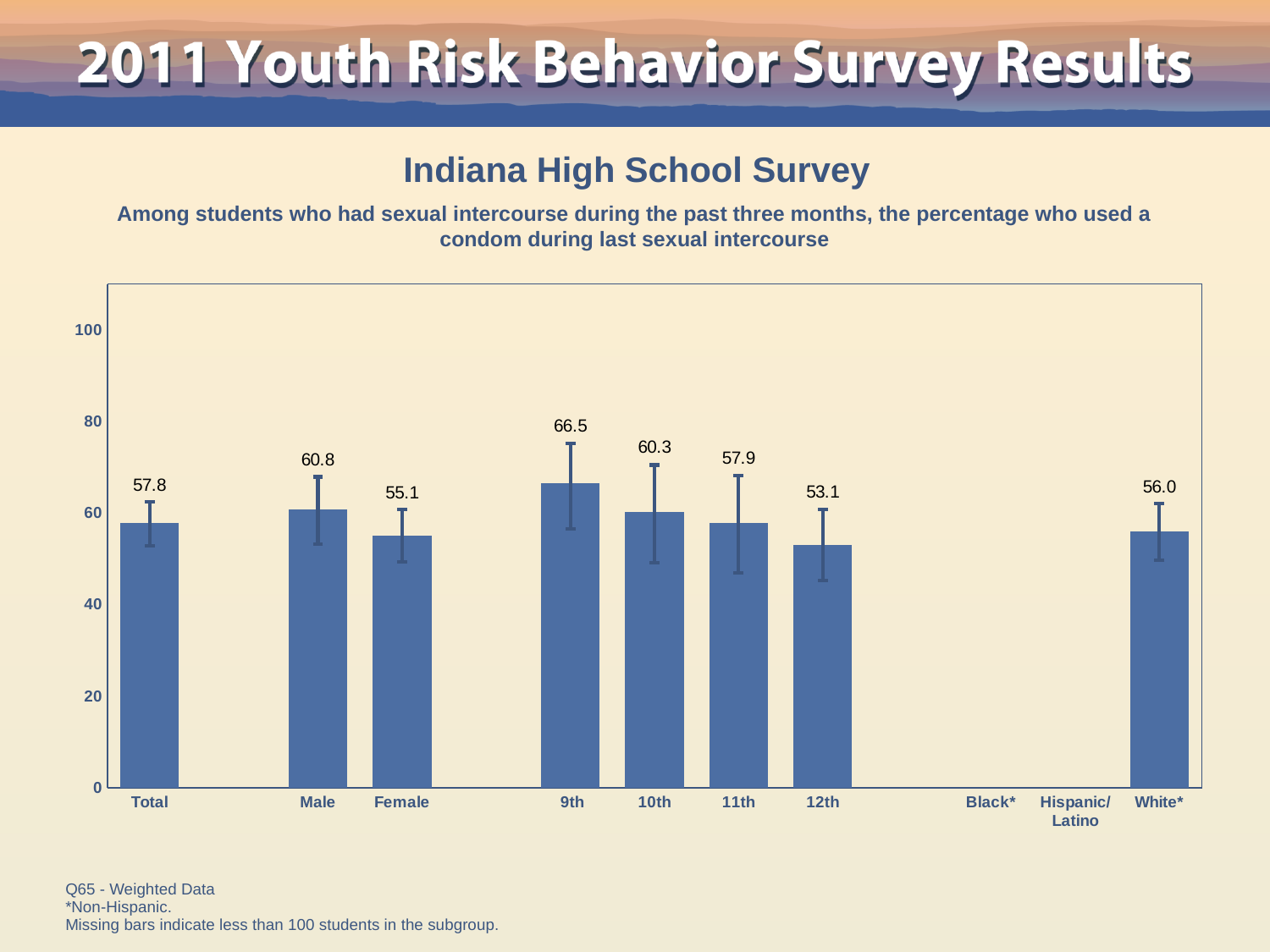
Which categories have no bar shown? Black* and Hispanic/Latino Which category has the highest value? 9th What is the value for White*? 56.0 What is the value for 9th grade? 66.5 What kind of chart is shown? bar chart What is the difference between the Male and Female values? 5.7 Is the value for 12th greater or less than 60? less Which is larger, the value for 10th or the value for 11th? 10th Which category with a plotted bar has the lowest value? 12th How many categories have a plotted bar? 8 Do the values rise or fall from 9th grade to 12th grade? fall What is the value for Total? 57.8